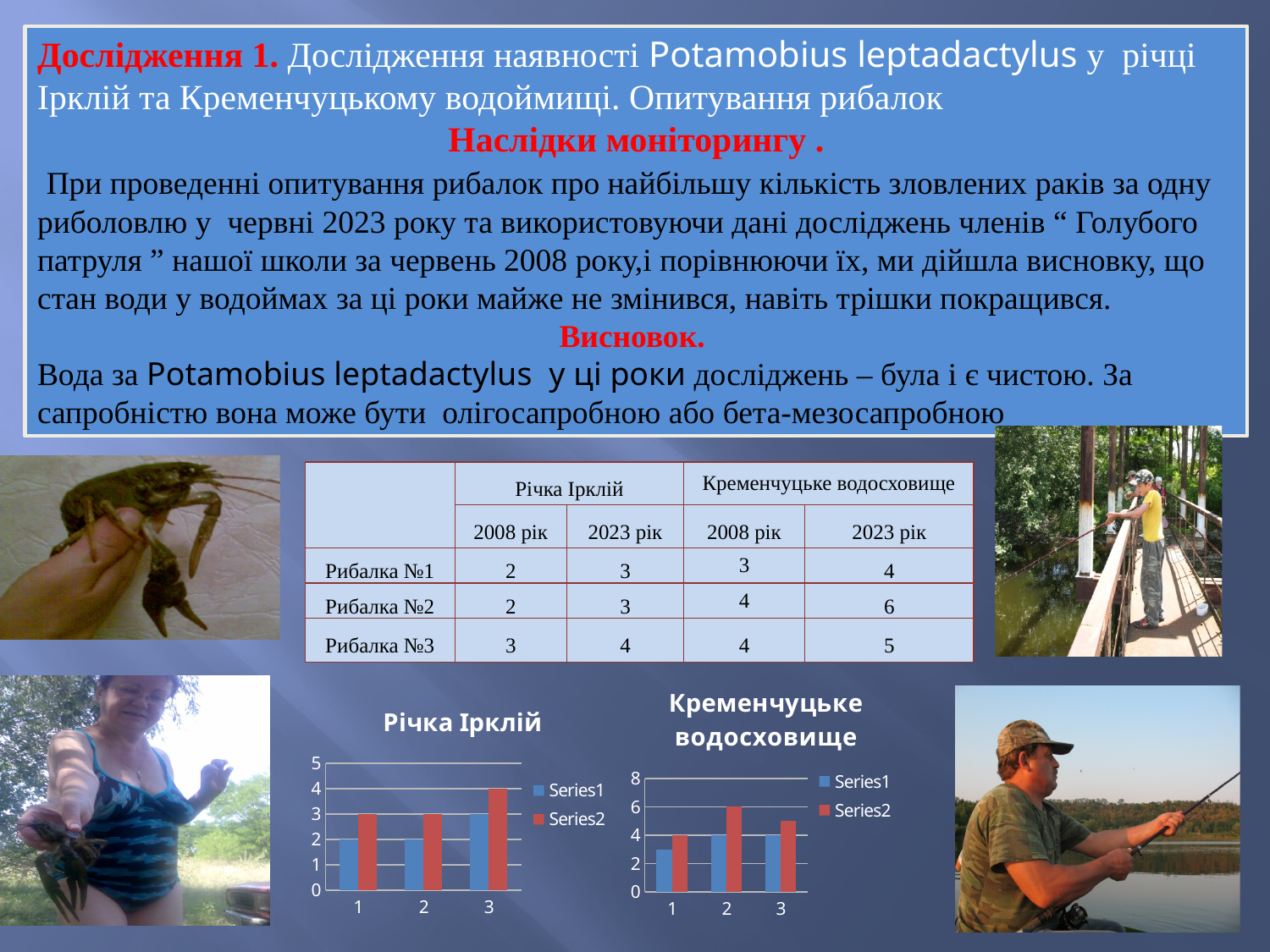
In the "Кременчуцьке водосховище" chart, what is the value of Series2 for category 2? 6 In the "Річка Ірклій" chart, what is the difference between Series2 and Series1 for category 2? 1 What type of chart is the "Річка Ірклій" chart? bar chart In the "Річка Ірклій" chart, which category has the highest Series1 value? 3 How many series does the legend of the "Кременчуцьке водосховище" chart list? 2 In the "Кременчуцьке водосховище" chart, what is the value of Series1 for category 3? 4 In the "Кременчуцьке водосховище" chart, is the value of Series1 for category 1 greater or less than 4? less In the "Річка Ірклій" chart, what is the value of Series1 for category 1? 2 In the "Кременчуцьке водосховище" chart, which is larger for category 3: Series1 or Series2? Series2 How many categories are shown on the x axis of the "Річка Ірклій" chart? 3 In the "Кременчуцьке водосховище" chart, which category has the highest Series2 value? 2 In the "Річка Ірклій" chart, what is the value of Series2 for category 3? 4